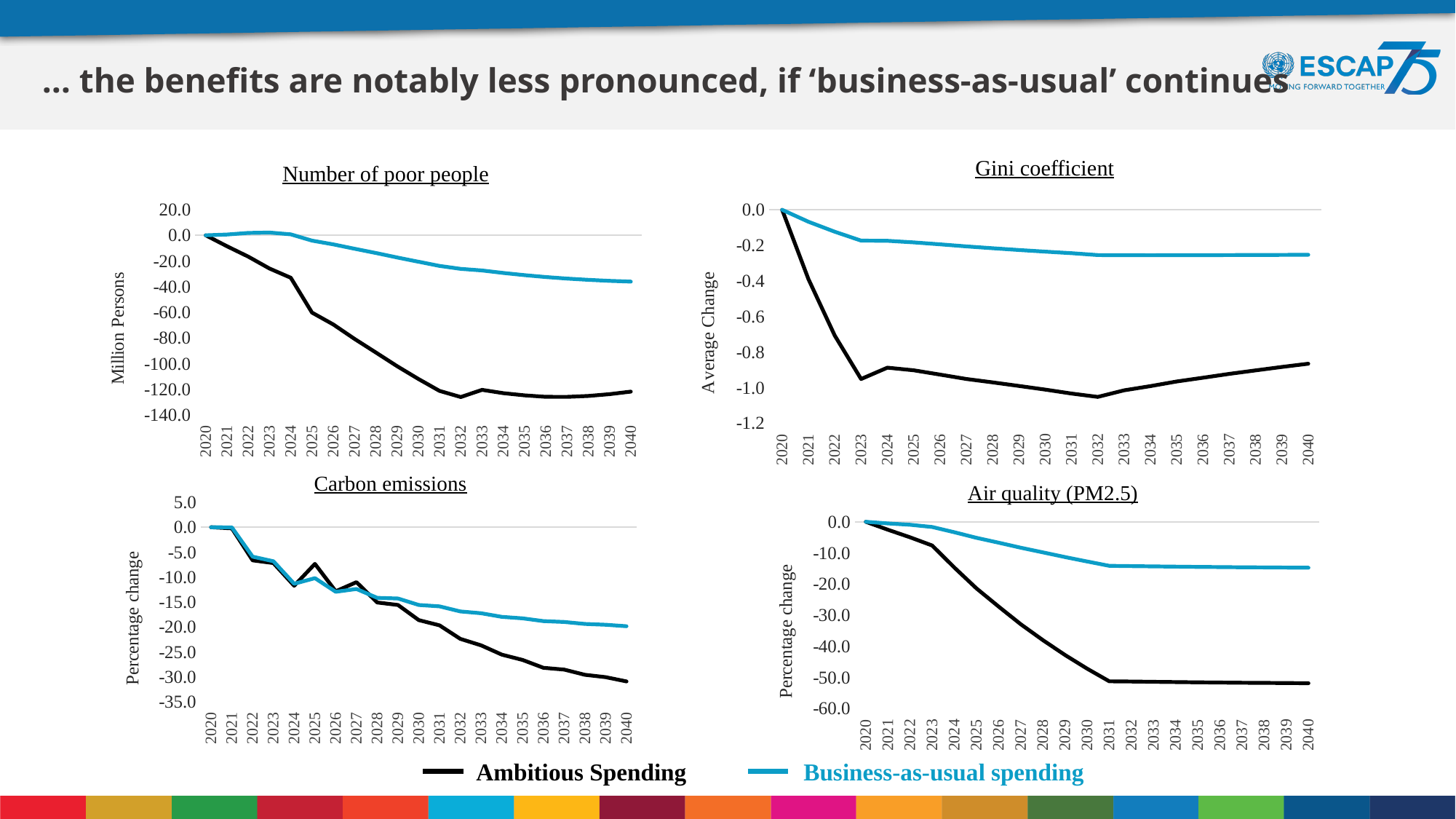
In the 'Air quality (PM2.5)' chart, is the Ambitious Spending value in 2040 greater or less than -40.0? less How many years are shown on the x axis of the 'Carbon emissions' chart? 21 In the 'Gini coefficient' chart, is the Ambitious Spending value in 2032 greater or less than -1.0? less In the 'Gini coefficient' chart, does the Business-as-usual spending line rise or fall from 2020 to 2040? fall What is the y-axis label of the 'Number of poor people' chart? Million Persons In the 'Carbon emissions' chart, is the Ambitious Spending value in 2040 greater or less than -25.0? less In the 'Air quality (PM2.5)' chart, which series has the lower value in 2040, Ambitious Spending or Business-as-usual spending? Ambitious Spending How many series does the legend at the bottom of the slide list? 2 What kind of chart is the 'Number of poor people' chart? line chart